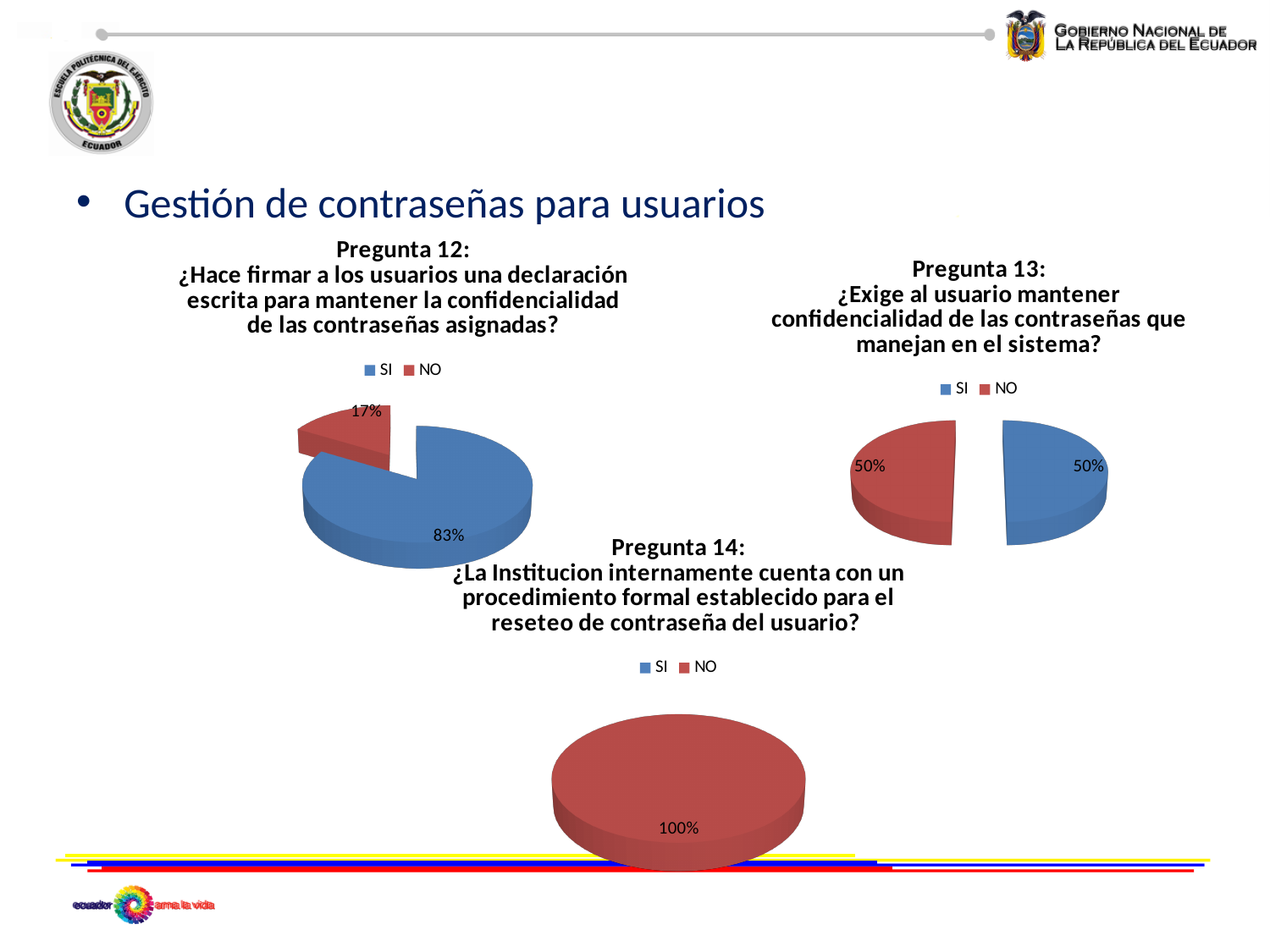
In the Pregunta 12 chart, what percentage is shown for SI? 83% In the Pregunta 12 chart, which category has the largest share? SI In the Pregunta 13 chart, what percentage is shown for SI? 50% What kind of chart is used for Pregunta 12? Pie chart In the Pregunta 13 chart, what percentage is shown for NO? 50% In the Pregunta 14 chart, which category has the largest share? NO In the Pregunta 12 chart, what percentage is shown for NO? 17% In the Pregunta 12 chart, what is the difference between the SI and NO shares? 66% In the Pregunta 14 chart, what percentage is shown for NO? 100% How many series does the legend of the Pregunta 13 chart list? 2 In the Pregunta 12 chart, which colour represents NO? Red How many pie charts are on the slide? 3